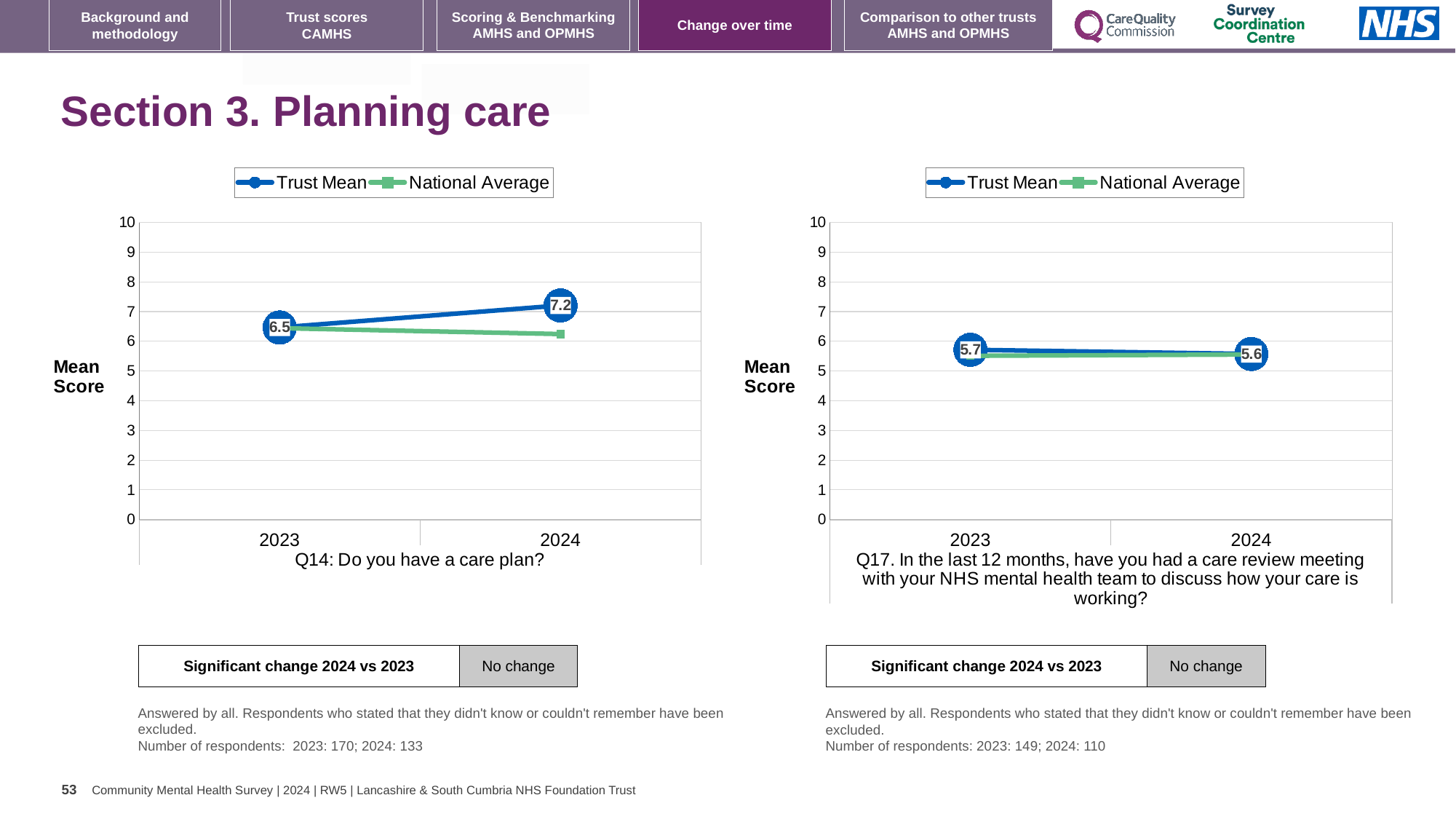
How many series does the legend of the Q14 chart (left) list? 2 In the Q17 chart (right), what is the Trust Mean score for 2023? 5.7 In the Q14 chart (left), what is the Trust Mean score for 2024? 7.2 In the Q17 chart (right), does the Trust Mean rise or fall from 2023 to 2024? fall In the Q14 chart (left), does the Trust Mean rise or fall from 2023 to 2024? rise How many years are plotted on the x axis of the Q17 chart (right)? 2 In the Q17 chart (right), what is the Trust Mean score for 2024? 5.6 In the Q14 chart (left), by how much did the Trust Mean change from 2023 to 2024? 0.7 In the Q14 chart (left), which is larger in 2024: the Trust Mean or the National Average? Trust Mean In the Q14 chart (left), what is the Trust Mean score for 2023? 6.5 What kind of chart is used on this slide? line chart In the Q14 chart (left), is the National Average for 2024 greater or less than 7? less